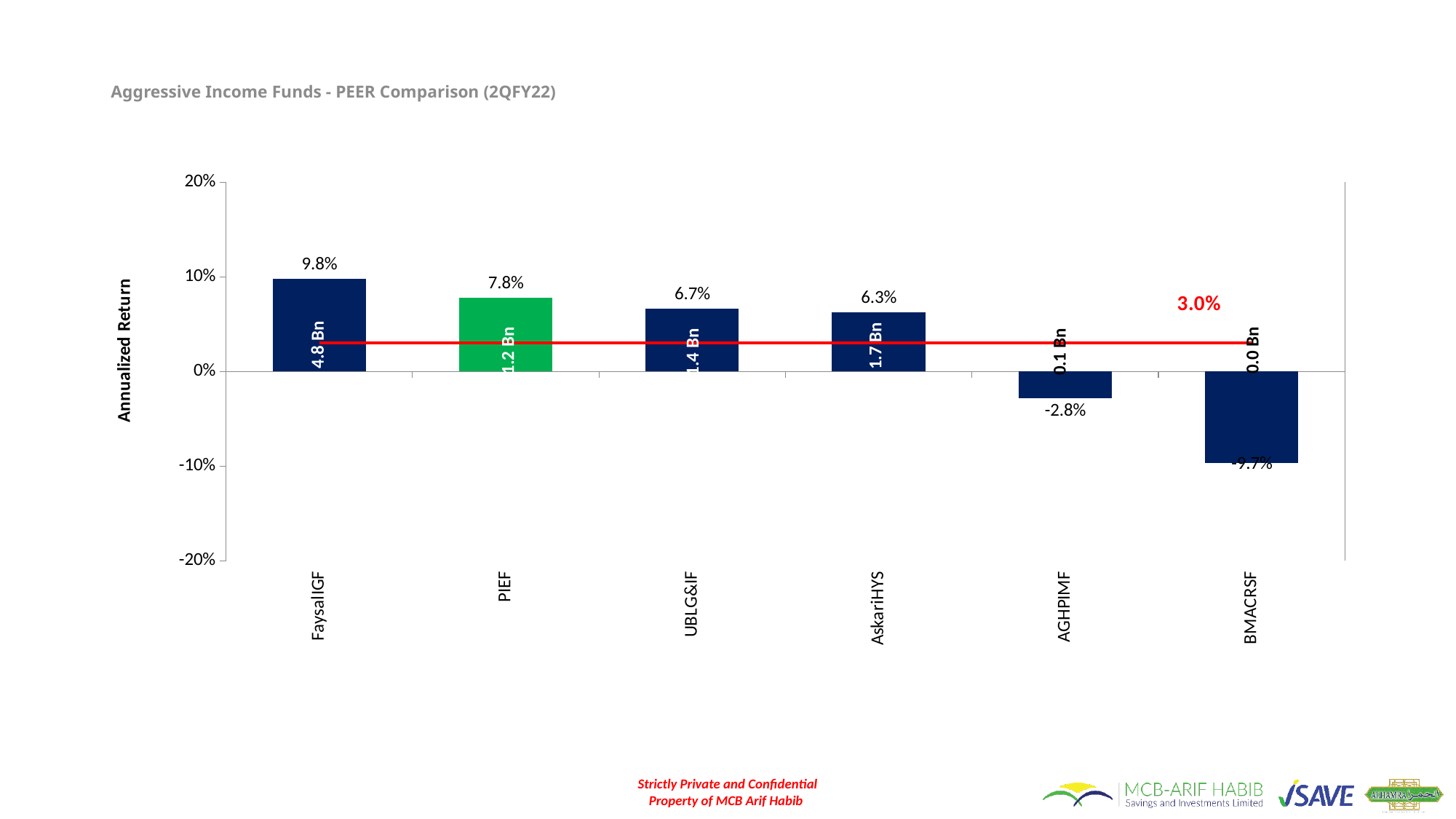
How many funds are shown on the chart? 6 What is the annualized return for BMACRSF? -9.7% What is the annualized return for AGHPIMF? -2.8% What is the title of the chart? Aggressive Income Funds - PEER Comparison (2QFY22) Which fund has the lowest annualized return? BMACRSF What is the annualized return for PIEF? 7.8% What kind of chart is shown on the slide? Bar chart Which has a higher annualized return, UBLG&IF or AskariHYS? UBLG&IF What is the difference between the annualized returns of FaysalIGF and PIEF? 2.0% What is the annualized return for FaysalIGF? 9.8% Which fund has the highest annualized return? FaysalIGF What value is labelled on the red horizontal line? 3.0%